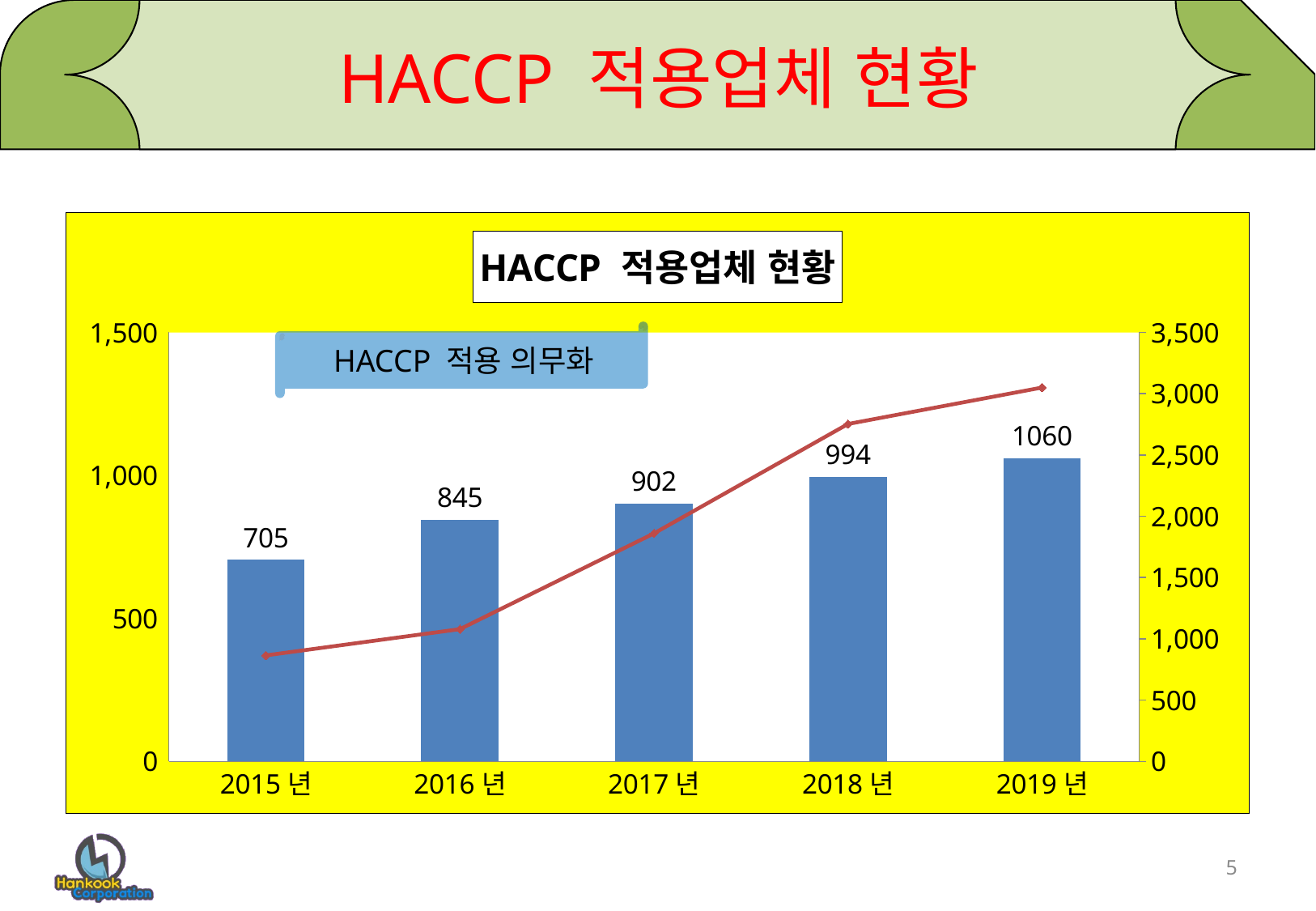
Which year has the highest bar value? 2019 년 Is the value of the red line for 2015 년 on the right-hand axis greater or less than 1,000? less Is the value of the red line for 2018 년 on the right-hand axis greater or less than 2,500? greater What is the title of the chart? HACCP 적용업체 현황 Do the bar values rise or fall from 2015 년 to 2019 년? rise What is the difference between the bar values for 2019 년 and 2015 년? 355 What is the value of the bar for 2019 년? 1060 Which bar is larger, 2016 년 or 2018 년? 2018 년 What is the value of the bar for 2015 년? 705 Which year has the lowest bar value? 2015 년 What is the value of the bar for 2017 년? 902 How many years are shown on the x axis? 5